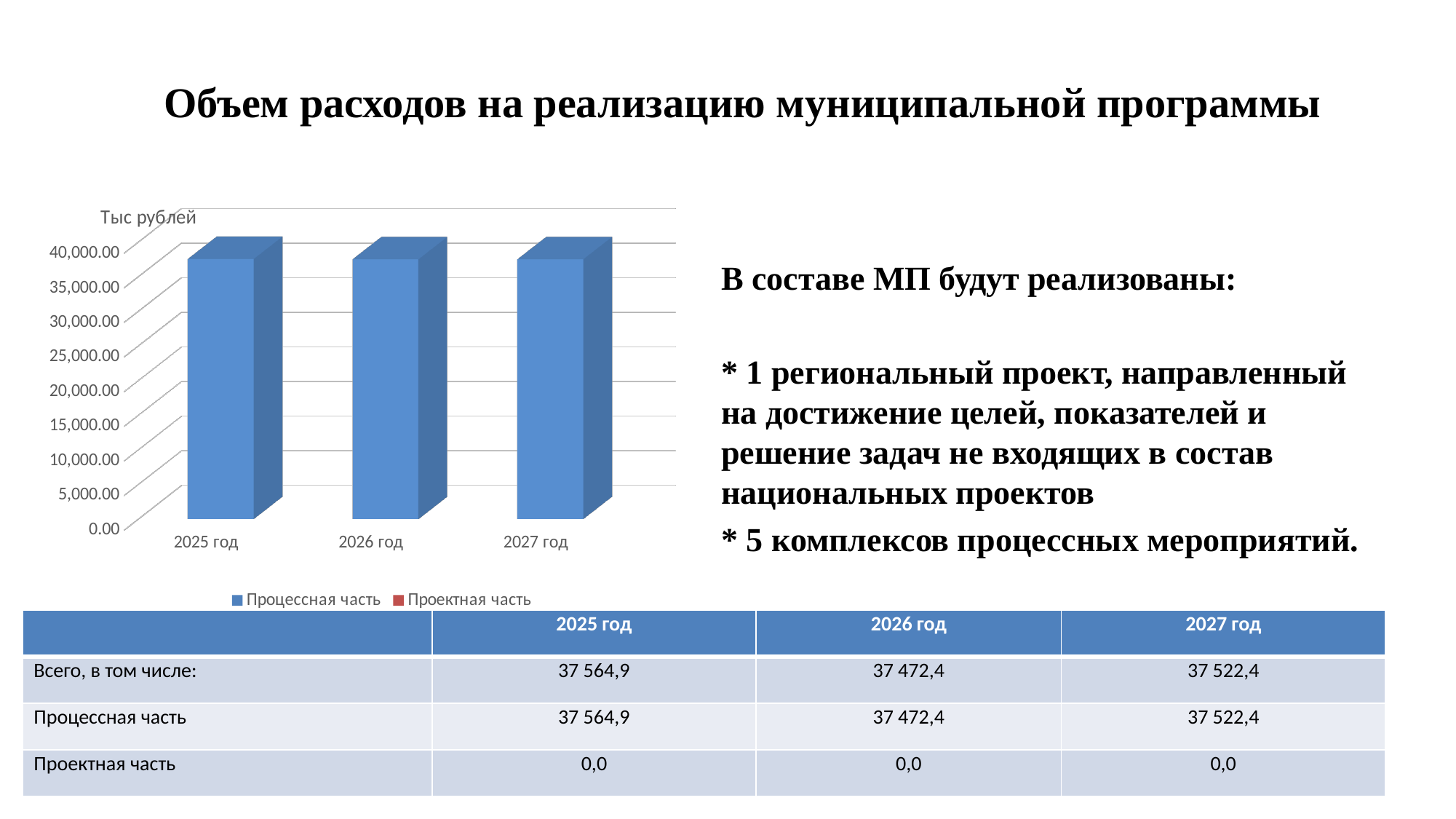
What unit label is shown above the vertical axis of the chart? Тыс рублей What kind of chart is shown on the slide? bar chart According to the table under the chart, what is the value of Процессная часть for 2025 год? 37 564,9 Is the value of the bar for 2027 год greater or less than 30,000.00? greater How many year categories are shown on the x axis of the chart? 3 How many series does the chart legend list? 2 Which series in the legend is shown in blue? Процессная часть Is the value of the bar for 2026 год greater or less than 35,000.00? greater According to the table under the chart, what is the value of Проектная часть for 2027 год? 0,0 Is the value of the bar for 2025 год greater or less than 40,000.00? less According to the table under the chart, what is the value of Процессная часть for 2026 год? 37 472,4